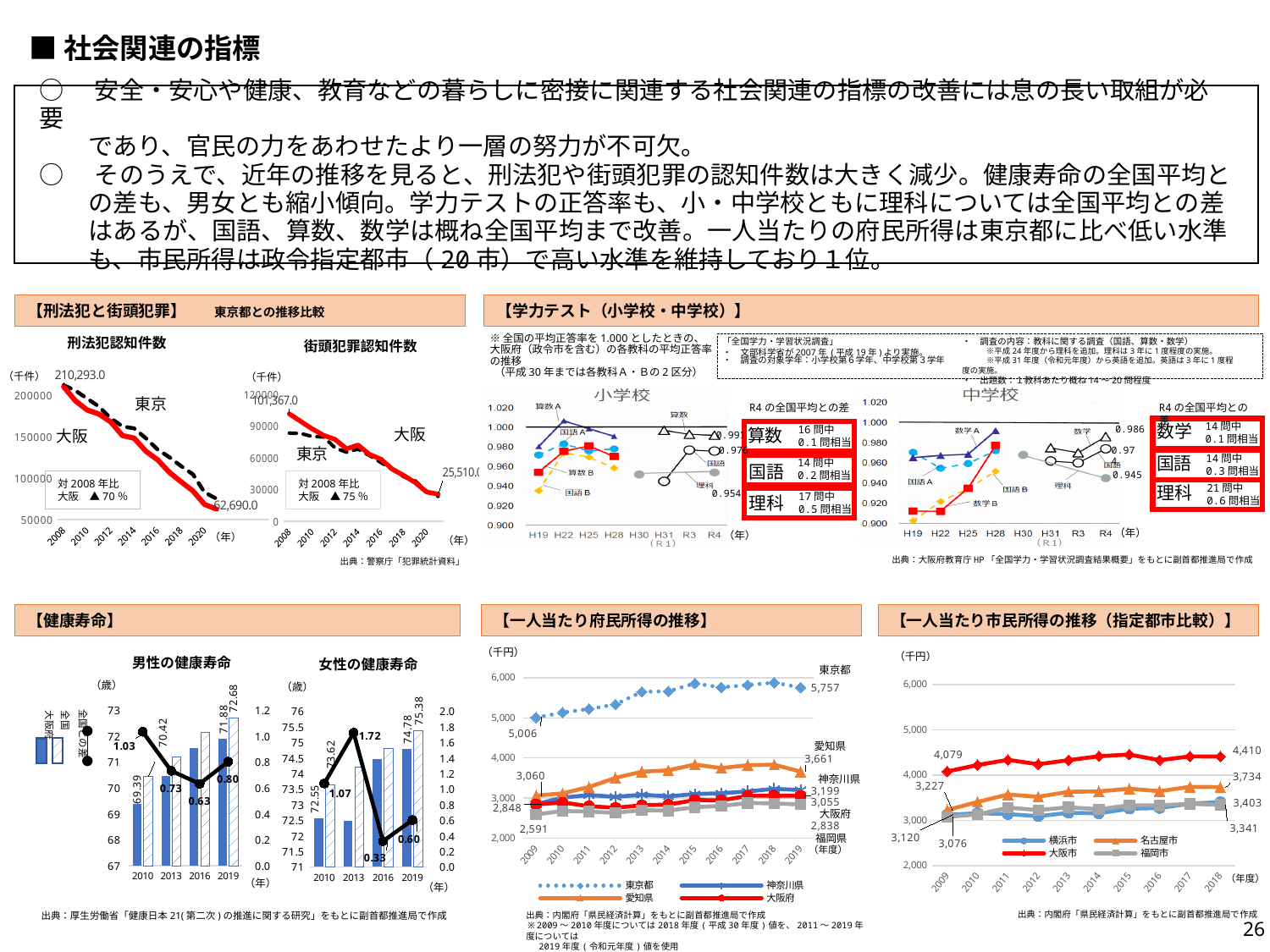
In the 街頭犯罪認知件数 chart, does the 大阪 line rise or fall from 2008 to 2020? fall In the 一人当たり府民所得の推移 chart, how many prefectures does the legend list? 5 In the 一人当たり府民所得の推移 chart, what is the value for 東京都 in 2019? 5,757 In the 一人当たり府民所得の推移 chart, what is the value for 福岡県 in 2009? 2,591 In the 一人当たり市民所得の推移（指定都市比較） chart, what is the difference between 名古屋市 and 福岡市 in 2018? 393 In the 一人当たり市民所得の推移（指定都市比較） chart, what is the value for 大阪市 in 2018? 4,410 In the 一人当たり市民所得の推移（指定都市比較） chart, which city has the lowest value in 2009? 福岡市 In the 男性の健康寿命 chart, what is the 全国との差 value for 2019? 0.80 In the 女性の健康寿命 chart, in which year is the 全国との差 the largest? 2013 In the 男性の健康寿命 chart, what is the 大阪府 value for 2010? 69.39 In the 一人当たり府民所得の推移 chart, which prefecture has the highest value in 2019? 東京都